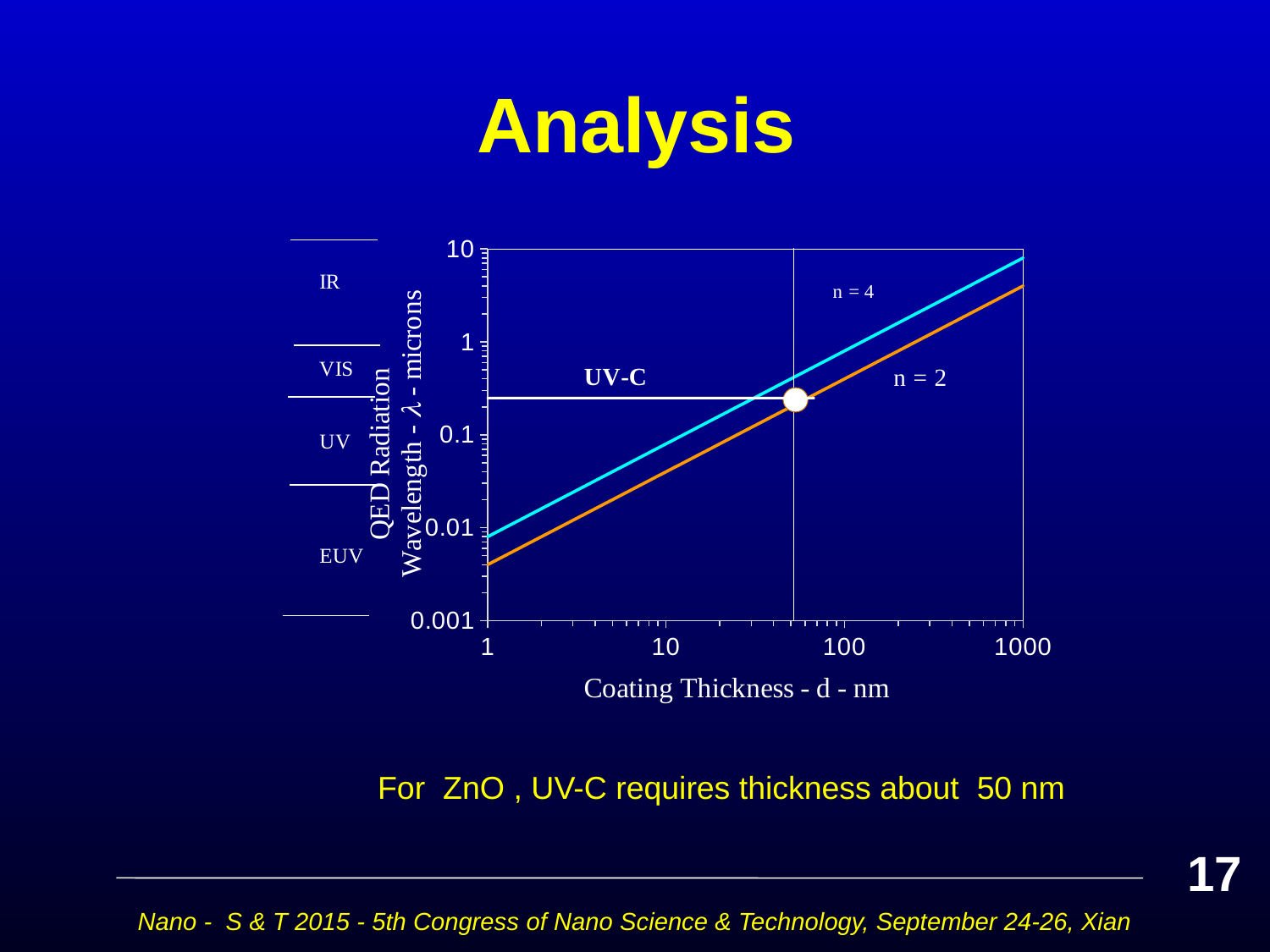
What are the labels of the two plotted lines? n = 4 and n = 2 What is the largest tick value shown on the x axis? 1000 At a coating thickness of 100 nm, is the value of the n = 2 line greater or less than 1 micron? less At a coating thickness of 1000 nm, is the value of the n = 4 line greater or less than 1 micron? greater How many lines (series) are plotted on the chart? 2 What is the title of the x axis? Coating Thickness - d - nm What kind of chart is shown on the slide? line chart Which line lies higher on the chart, n = 4 or n = 2? n = 4 At a coating thickness of 1 nm, is the value of the n = 2 line greater or less than 0.01 microns? less Do the plotted wavelength values rise or fall as coating thickness increases? rise What is the smallest tick value shown on the y axis? 0.001